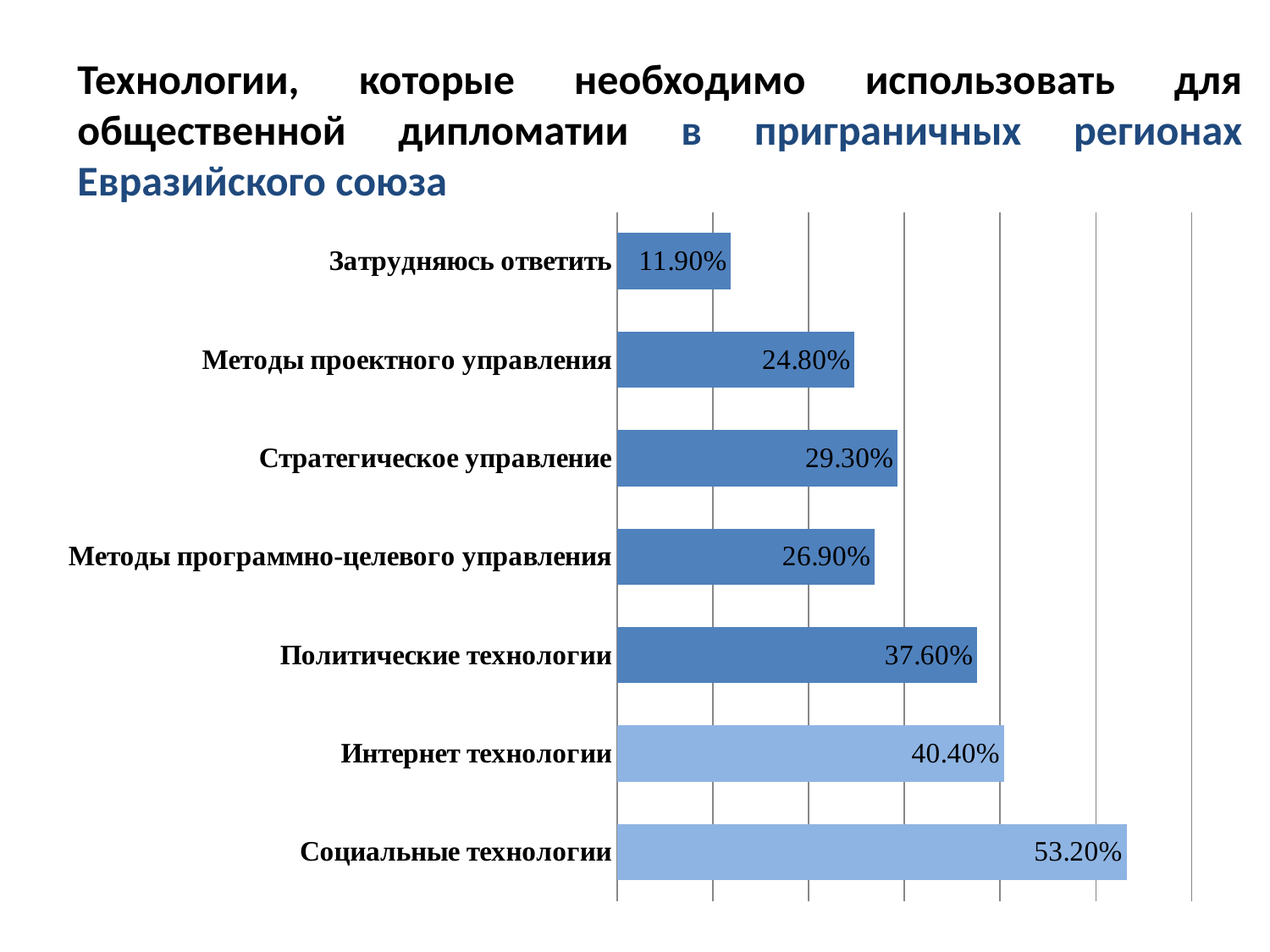
What value is shown for Социальные технологии? 53.20% What is the difference between the values for Политические технологии and Стратегическое управление? 8.30% How many categories are shown in the chart? 7 What value is shown for Интернет технологии? 40.40% Which category has the highest value? Социальные технологии Which category has the lowest value? Затрудняюсь ответить What kind of chart is shown on the slide? Bar chart What is the difference between the values for Социальные технологии and Интернет технологии? 12.80% What value is shown for Методы проектного управления? 24.80% Which is larger, the value for Стратегическое управление or the value for Методы программно-целевого управления? Стратегическое управление Which category has the second-highest value? Интернет технологии What value is shown for Затрудняюсь ответить? 11.90%